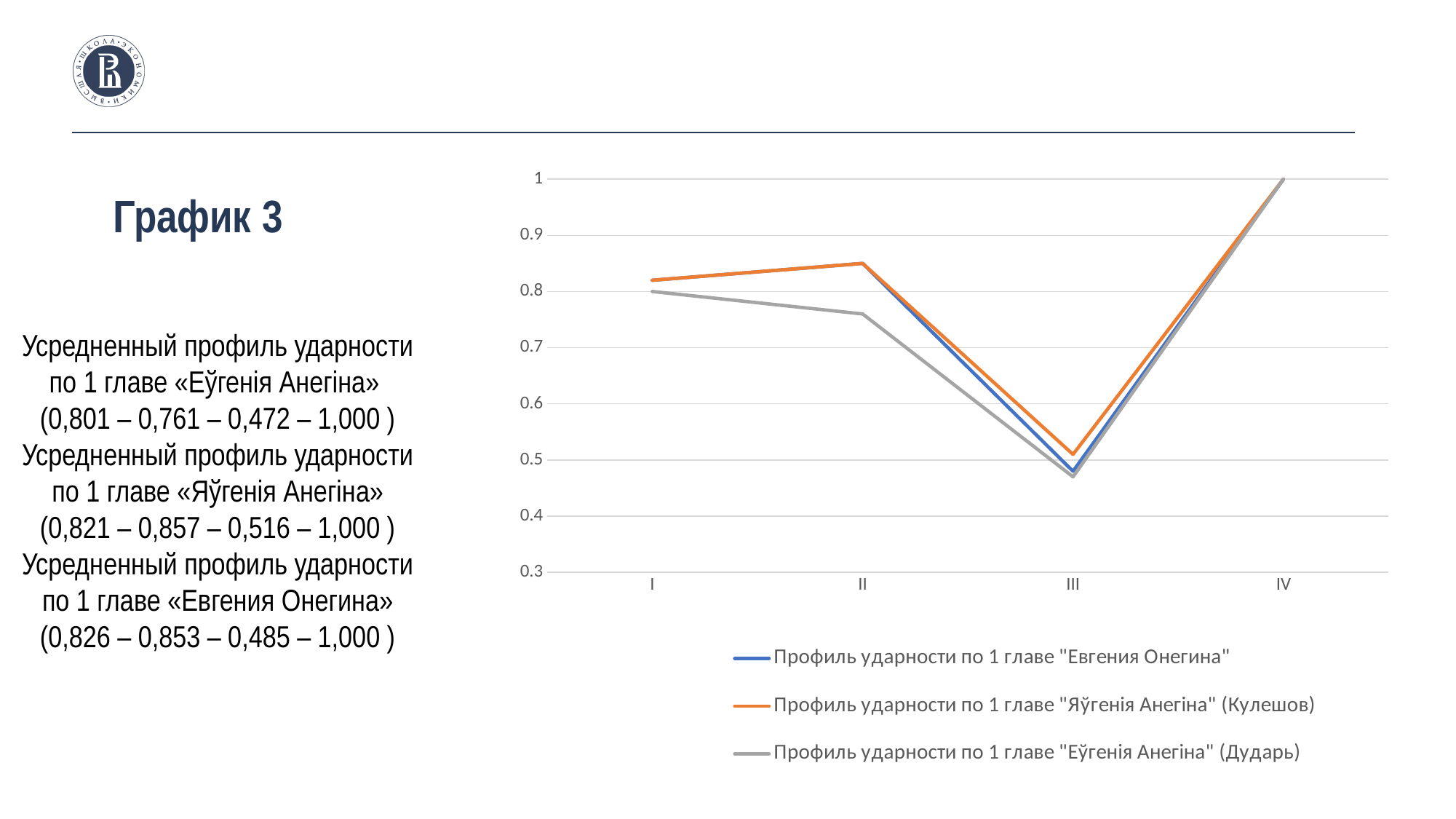
How many points are plotted along the x axis for each series? 4 Do the values of all three series rise or fall from II to III? fall At category I, which series has the higher value: "Яўгенія Анегіна" (Кулешов) or "Еўгенія Анегіна" (Дударь)? Яўгенія Анегіна (Кулешов) Is the value for "Яўгенія Анегіна" (Кулешов) at II greater or less than 0.8? greater At which x-axis category does the series "Яўгенія Анегіна" (Кулешов) reach its highest value? IV What is the title shown on the slide for this chart? График 3 At which x-axis category does the series "Еўгенія Анегіна" (Дударь) reach its lowest value? III What kind of chart is shown on the slide? line chart What value do all three series reach at category IV? 1 Is the value for "Еўгенія Анегіна" (Дударь) at II greater or less than 0.8? less Is the value for "Еўгенія Анегіна" (Дударь) at III greater or less than 0.5? less How many series does the chart legend list? 3